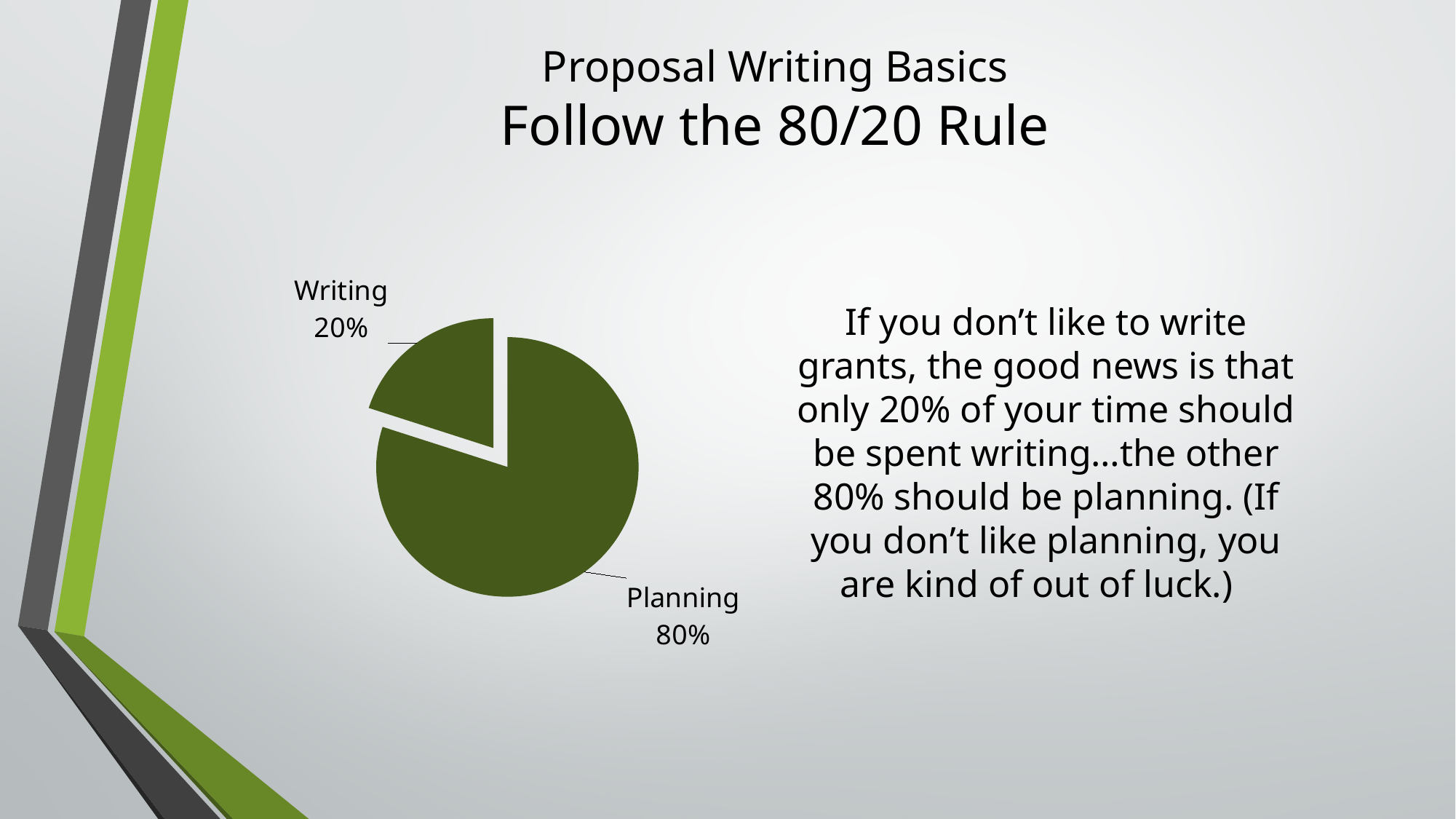
Which slice of the pie is the largest? Planning What share of the pie does the Writing slice take up? 20% What is the difference in percentage points between the Planning and Writing slices? 60 What percentage does the Planning slice represent? 80% Which slice is pulled out (exploded) from the rest of the pie? Writing What share of the pie does the Planning slice take up? 80% How many slices does the pie chart have? 2 Which is larger, the Writing slice or the Planning slice? Planning What colour are the slices of the pie chart? dark green What kind of chart is shown on the slide? pie chart Which slice of the pie is the smallest? Writing What percentage does the Writing slice represent? 20%